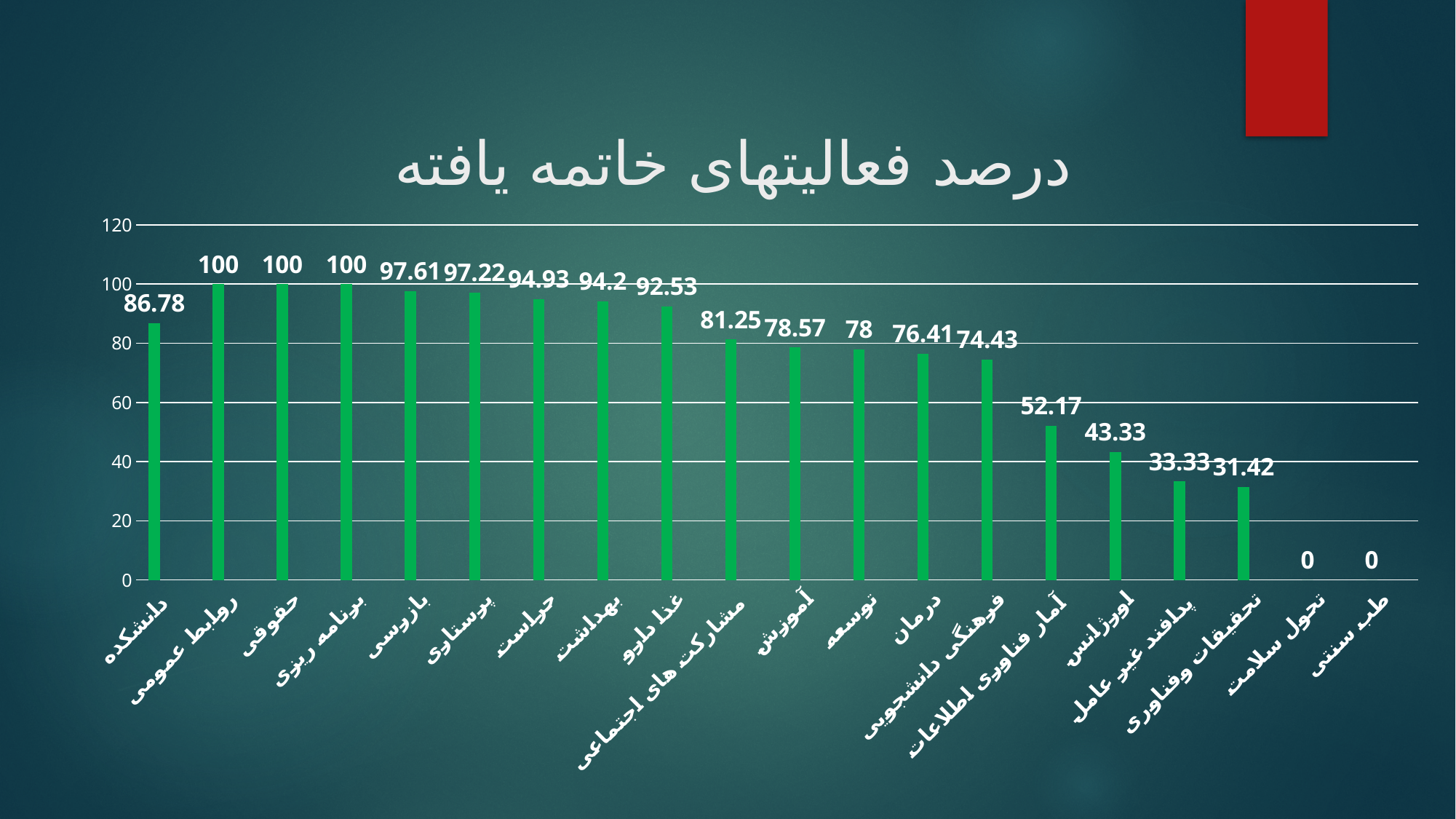
What kind of chart is shown on the slide? bar chart What is the difference between the values for اورژانس and پدافند غیر عامل? 10 What is the title of the chart? درصد فعالیتهای خاتمه یافته What is the value for توسعه? 78 Is the value for مشارکت های اجتماعی greater or less than 80? greater Which category has the lowest value among those with a non-zero bar? تحقیقات وفناوری What is the value for دانشکده? 86.78 What is the value for آمار فناوری اطلاعات? 52.17 How many categories are shown on the x axis? 20 What is the value for تحقیقات وفناوری? 31.42 Which is larger, the value for درمان or the value for فرهنگی دانشجویی? درمان What is the value for بازرسی? 97.61